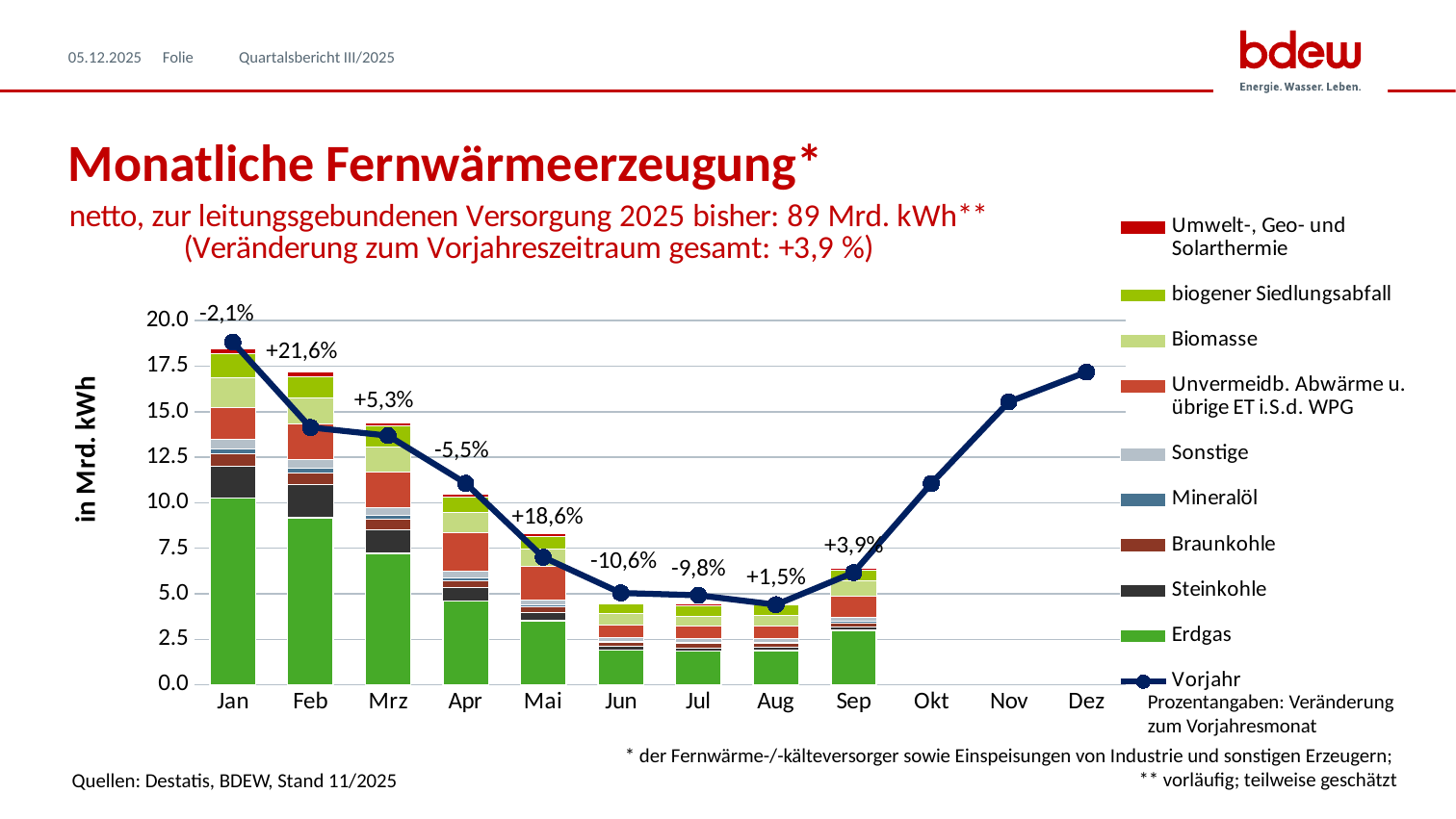
Does the Vorjahr line rise or fall from Jan to Jun? fall What is the y-axis label of the chart? in Mrd. kWh What percentage change is shown for Jun? -10,6% Is the total stacked bar for Jan greater or less than 15.0 Mrd. kWh? greater What percentage change is shown for Mai? +18,6% Which month has the highest percentage change label? Feb Which month has a taller stacked bar, Jan or Sep? Jan How many months have stacked bars plotted? 9 How many entries does the legend list? 10 What percentage change is shown above the Feb bar? +21,6% Is the total stacked bar for Jun greater or less than 5.0 Mrd. kWh? less Which month has the lowest percentage change label? Jun